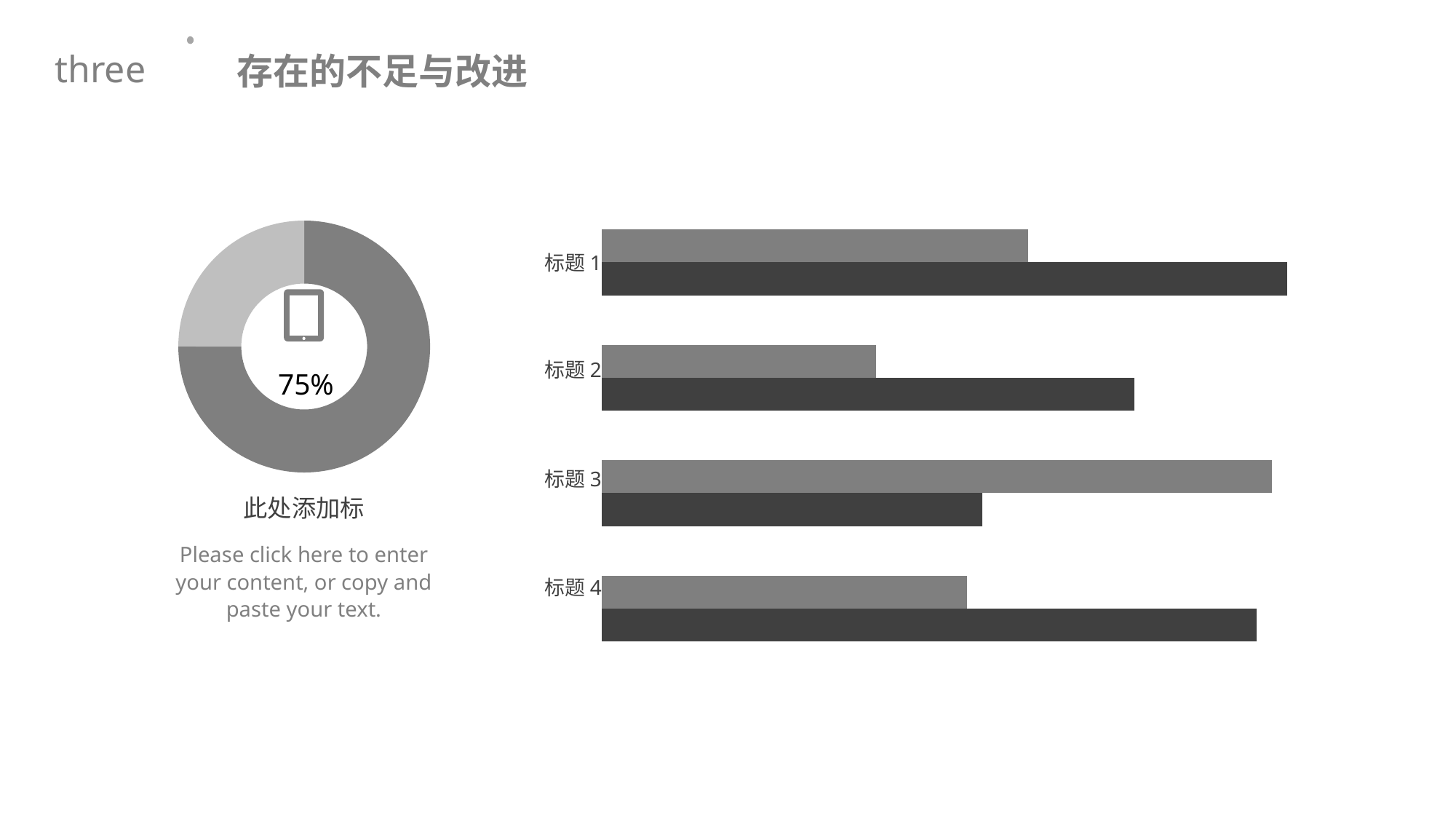
How many categories does the bar chart on the right of the slide show? 4 In the bar chart on the right, which category has the shortest dark grey bar? 标题 3 What is the caption text shown directly below the donut chart on the left of the slide? 此处添加标 In the bar chart on the right, for 标题 2, which bar is longer: the lighter grey bar or the dark grey bar? The dark grey bar What kind of chart is the chart on the right of the slide? Bar chart How many bars are shown for each category in the bar chart on the right of the slide? 2 In the bar chart on the right, for 标题 1, which bar is longer: the lighter grey bar or the dark grey bar? The dark grey bar In the bar chart on the right, which category has the shortest lighter grey bar? 标题 2 In the bar chart on the right, which category has the longest lighter grey bar? 标题 3 What percentage is displayed in the centre of the donut chart on the left of the slide? 75% What kind of chart is the chart on the left of the slide? Donut chart In the bar chart on the right, for 标题 3, which bar is longer: the lighter grey bar or the dark grey bar? The lighter grey bar